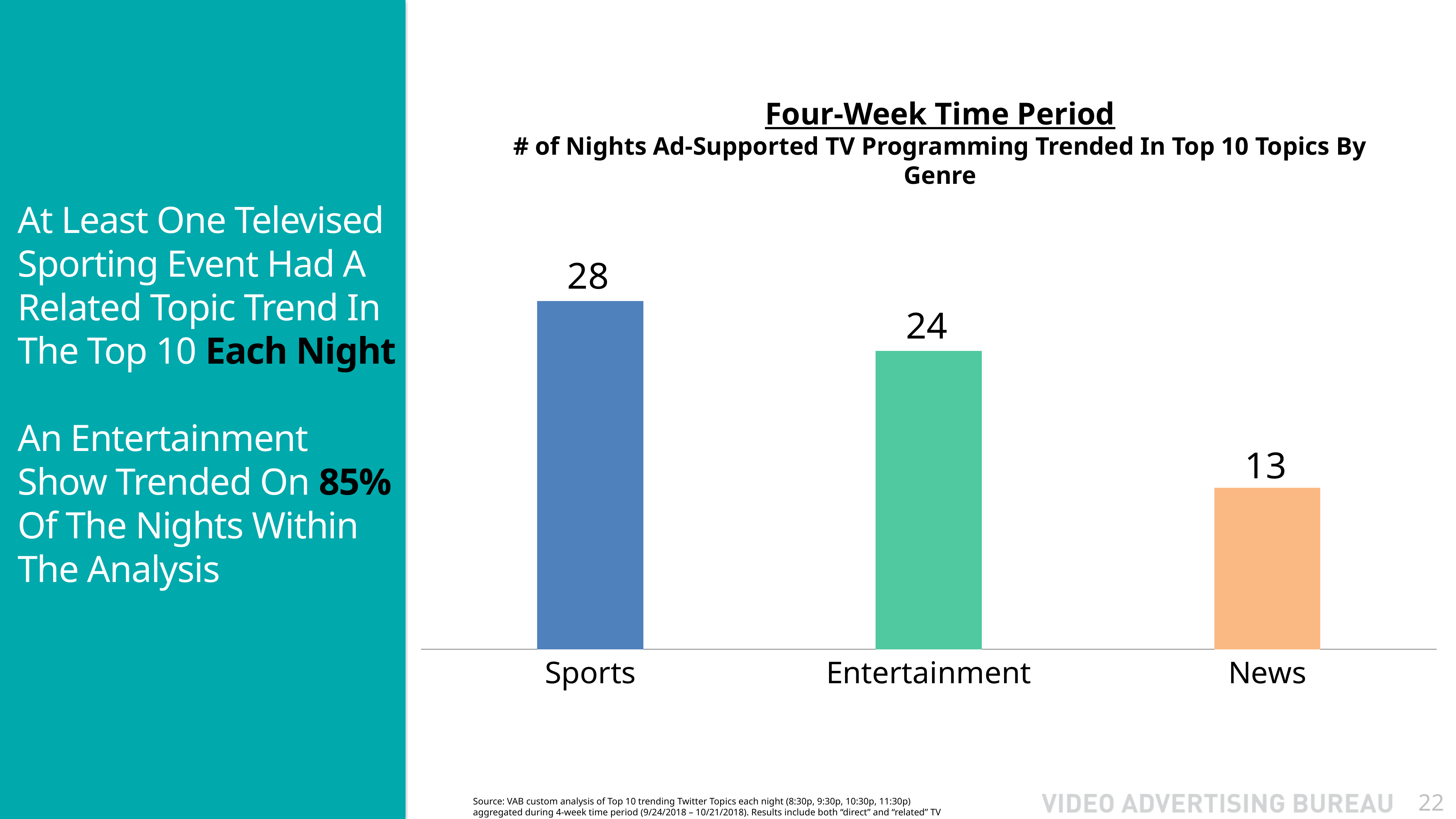
Which genre has a higher number of nights, Entertainment or News? Entertainment What is the difference in number of nights between Entertainment and News? 11 How many nights did Sports programming trend in the Top 10 topics? 28 What type of chart is shown on the slide? Bar chart How many genres are shown in the chart? 3 Do the values rise or fall moving from Sports to News along the x axis? Fall What is the underlined title of the chart? Four-Week Time Period How many nights did News programming trend in the Top 10 topics? 13 Which genre trended in the Top 10 topics on the most nights? Sports What is the difference in number of nights between Sports and Entertainment? 4 How many nights did Entertainment programming trend in the Top 10 topics? 24 Which genre trended in the Top 10 topics on the fewest nights? News